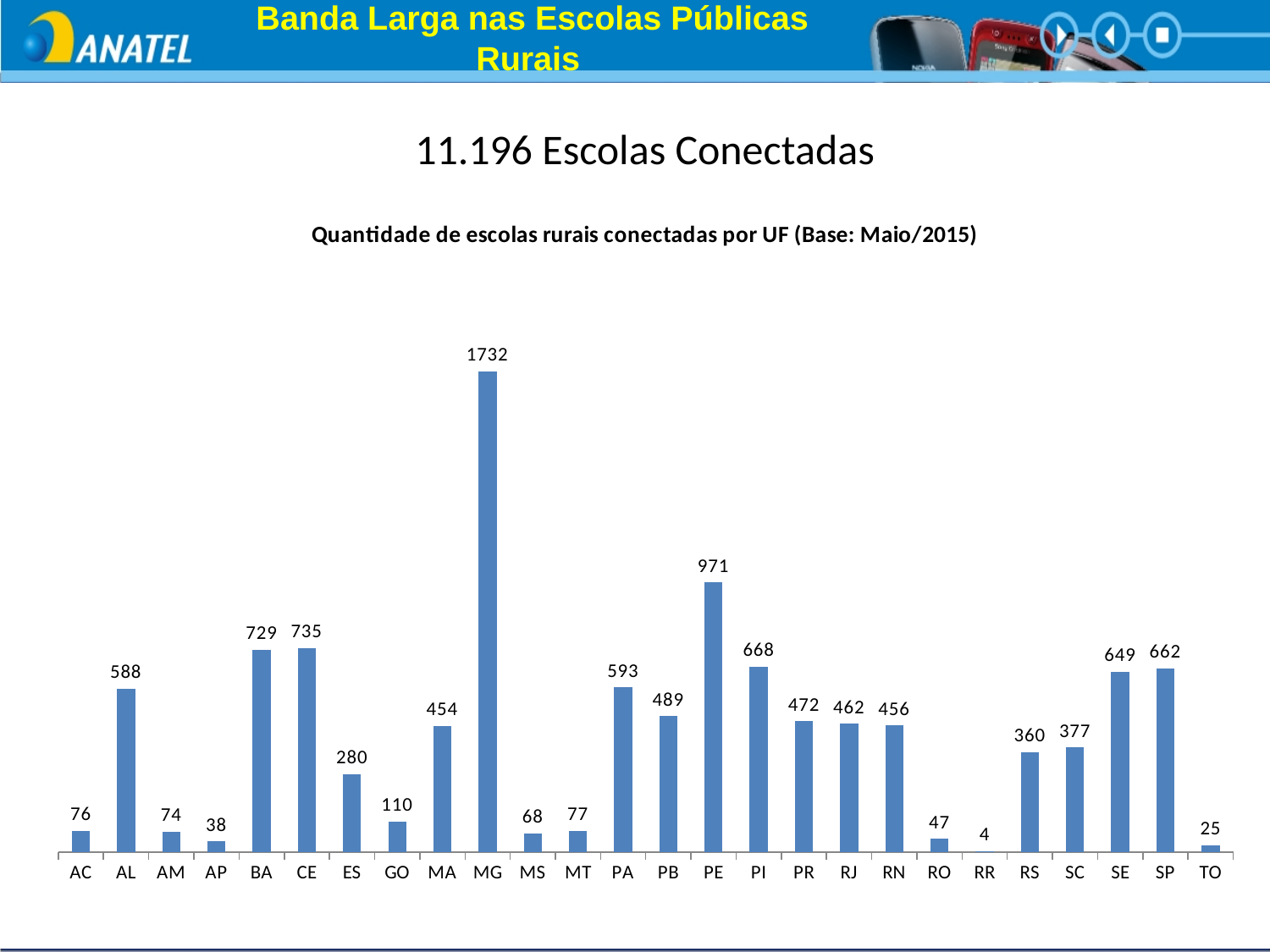
What kind of chart is shown on the slide? Bar chart Which UF has the highest number of connected rural schools? MG What is the title of the chart? Quantidade de escolas rurais conectadas por UF (Base: Maio/2015) Which is larger, the value for PA or the value for PI? PI What is the value for RR? 4 How many UFs (categories) are shown on the x axis? 26 Which is larger, the value for SP or the value for SE? SP Which UF has the lowest number of connected rural schools? RR What is the value for PE? 971 What is the difference between the values for MG and PE? 761 What is the difference between the values for CE and BA? 6 What is the value for MG? 1732